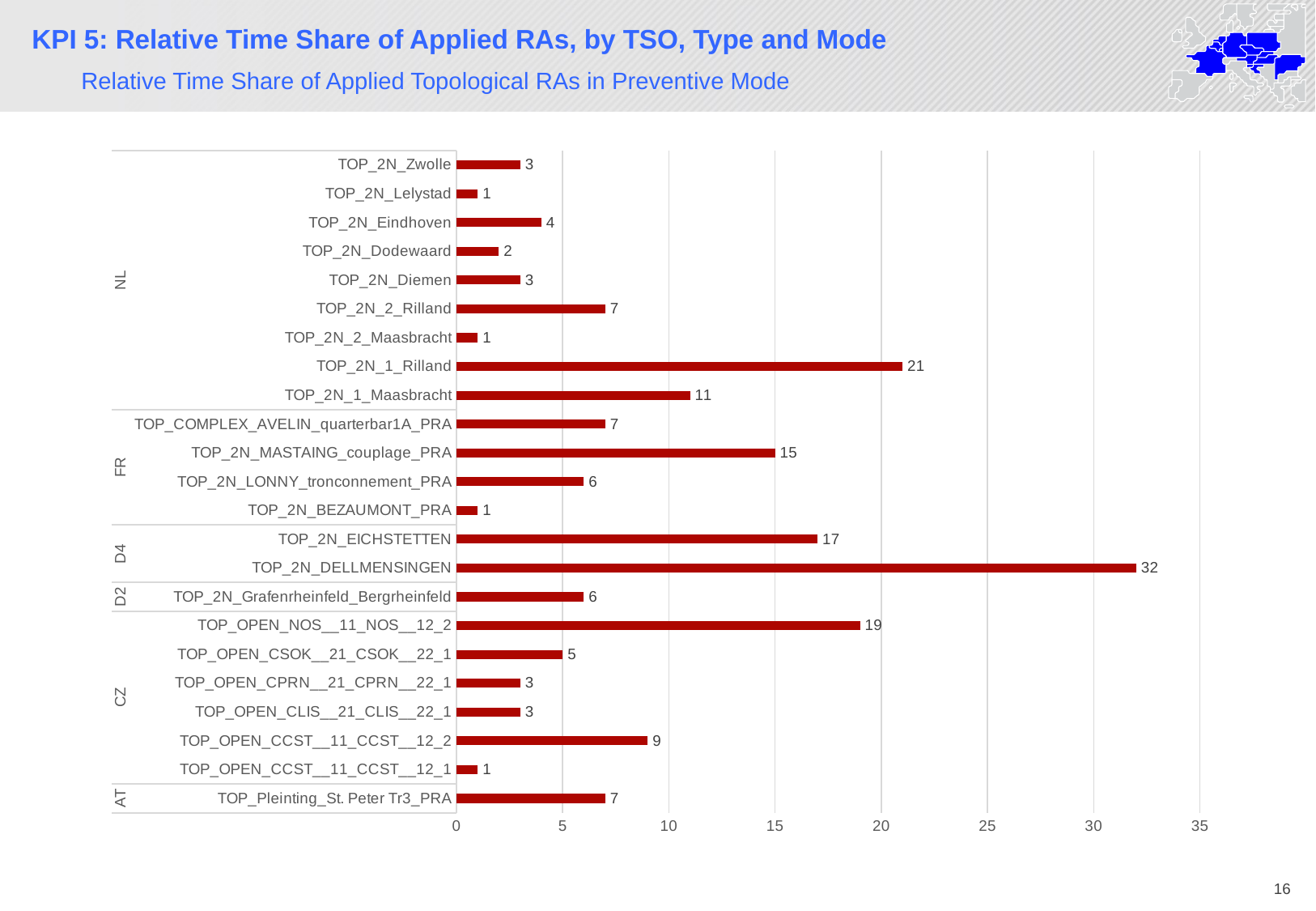
Is the value for TOP_2N_EICHSTETTEN greater or less than 15? greater Which category has the highest value? TOP_2N_DELLMENSINGEN What is the value for TOP_Pleinting_St. Peter Tr3_PRA? 7 Which is larger, the value for TOP_OPEN_CCST__11_CCST__12_2 or the value for TOP_2N_2_Rilland? TOP_OPEN_CCST__11_CCST__12_2 What is the value for TOP_2N_1_Rilland? 21 What kind of chart is shown on the slide? bar chart What is the value for TOP_2N_MASTAING_couplage_PRA? 15 What is the value for TOP_2N_DELLMENSINGEN? 32 What is the value for TOP_OPEN_NOS__11_NOS__12_2? 19 What is the difference between the values for TOP_2N_1_Rilland and TOP_2N_1_Maasbracht? 10 What is the difference between the values for TOP_2N_DELLMENSINGEN and TOP_2N_EICHSTETTEN? 15 How many categories (bars) are shown in the chart? 23